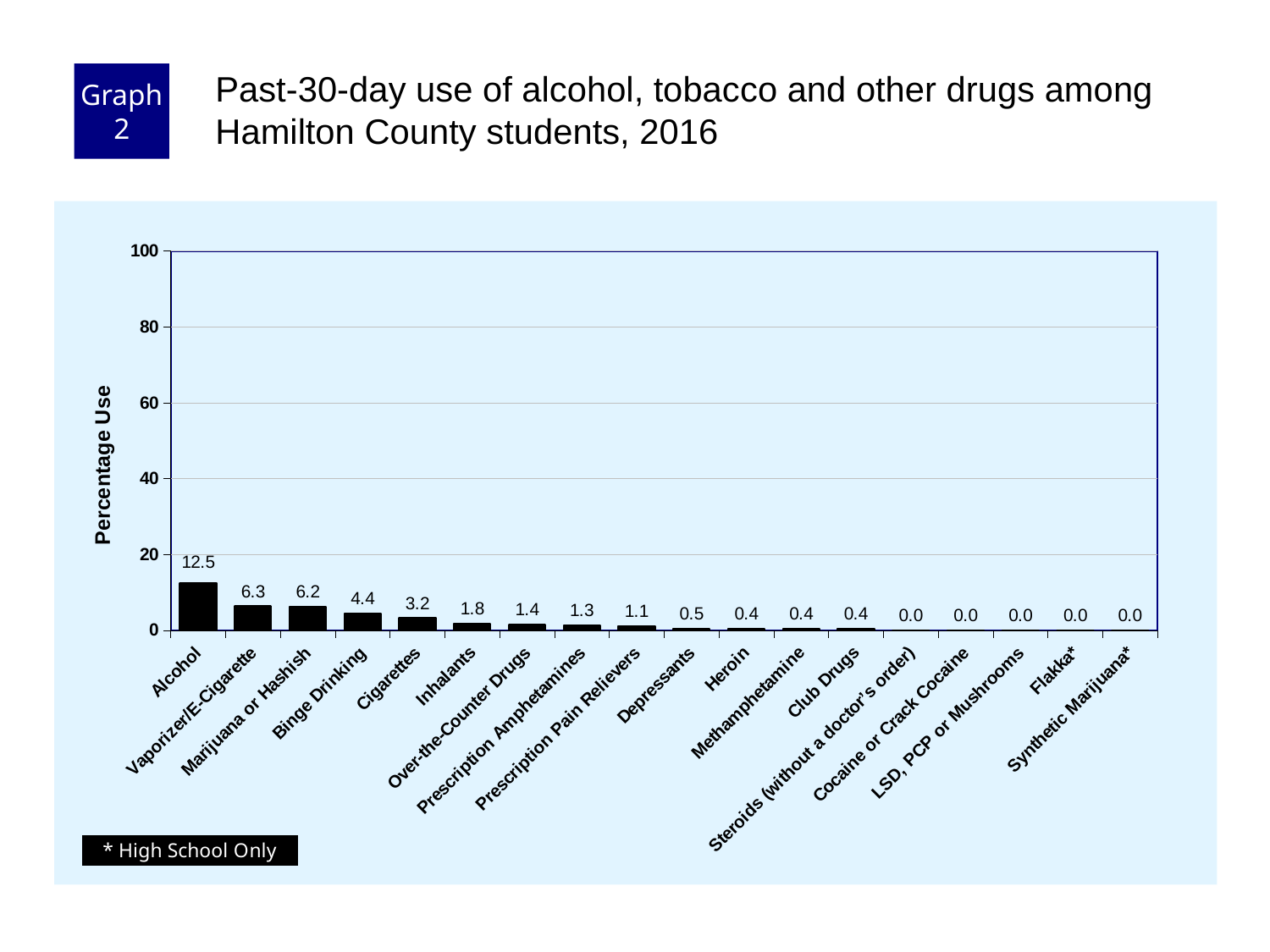
Do the values rise or fall moving left to right along the x axis? fall What is the percentage use for Binge Drinking? 4.4 What is the percentage use for Alcohol? 12.5 Is the value for Alcohol greater or less than 20? less Which category has the highest percentage use? Alcohol What kind of chart is shown on the slide? bar chart What is the difference in percentage use between Vaporizer/E-Cigarette and Marijuana or Hashish? 0.1 What is the percentage use for Inhalants? 1.8 How many categories are shown on the x axis? 18 Which has a higher percentage use, Binge Drinking or Cigarettes? Binge Drinking What is the difference in percentage use between Alcohol and Cigarettes? 9.3 What is the label of the y axis? Percentage Use